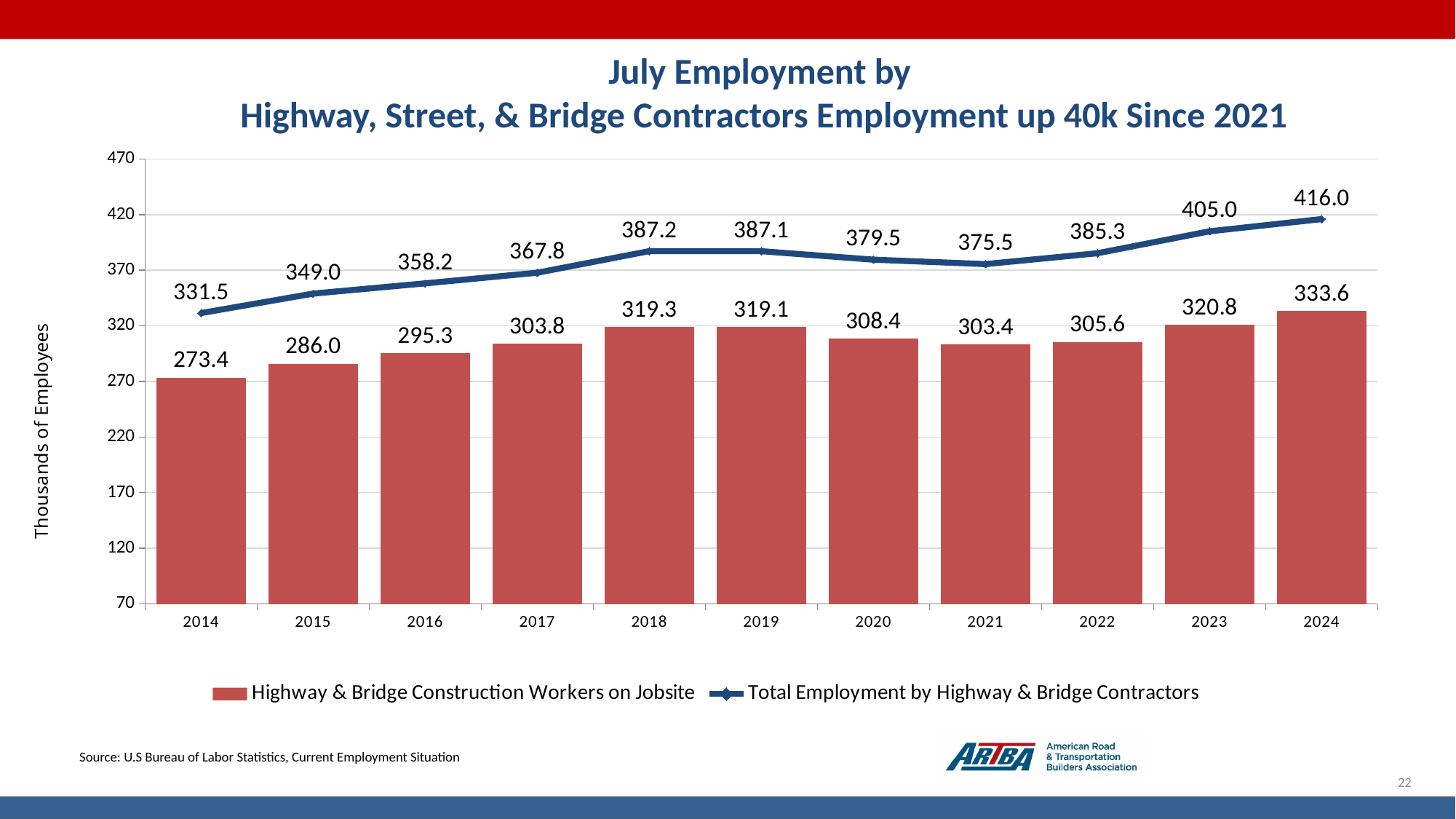
Which is larger: Highway & Bridge Construction Workers on Jobsite in 2018 or in 2020? 2018 How many series does the legend list? 2 Is the value for Highway & Bridge Construction Workers on Jobsite in 2016 greater or less than 320? less What kind of chart is this? Combined bar and line chart What is the difference between Total Employment by Highway & Bridge Contractors in 2024 and in 2021? 40.5 How many years are shown on the x axis? 11 What is the value for Total Employment by Highway & Bridge Contractors in 2024? 416.0 Which year has the highest value for Highway & Bridge Construction Workers on Jobsite? 2024 Which year has the lowest value for Total Employment by Highway & Bridge Contractors? 2014 What is the y-axis label of the chart? Thousands of Employees What is the value for Total Employment by Highway & Bridge Contractors in 2021? 375.5 What is the value for Highway & Bridge Construction Workers on Jobsite in 2014? 273.4